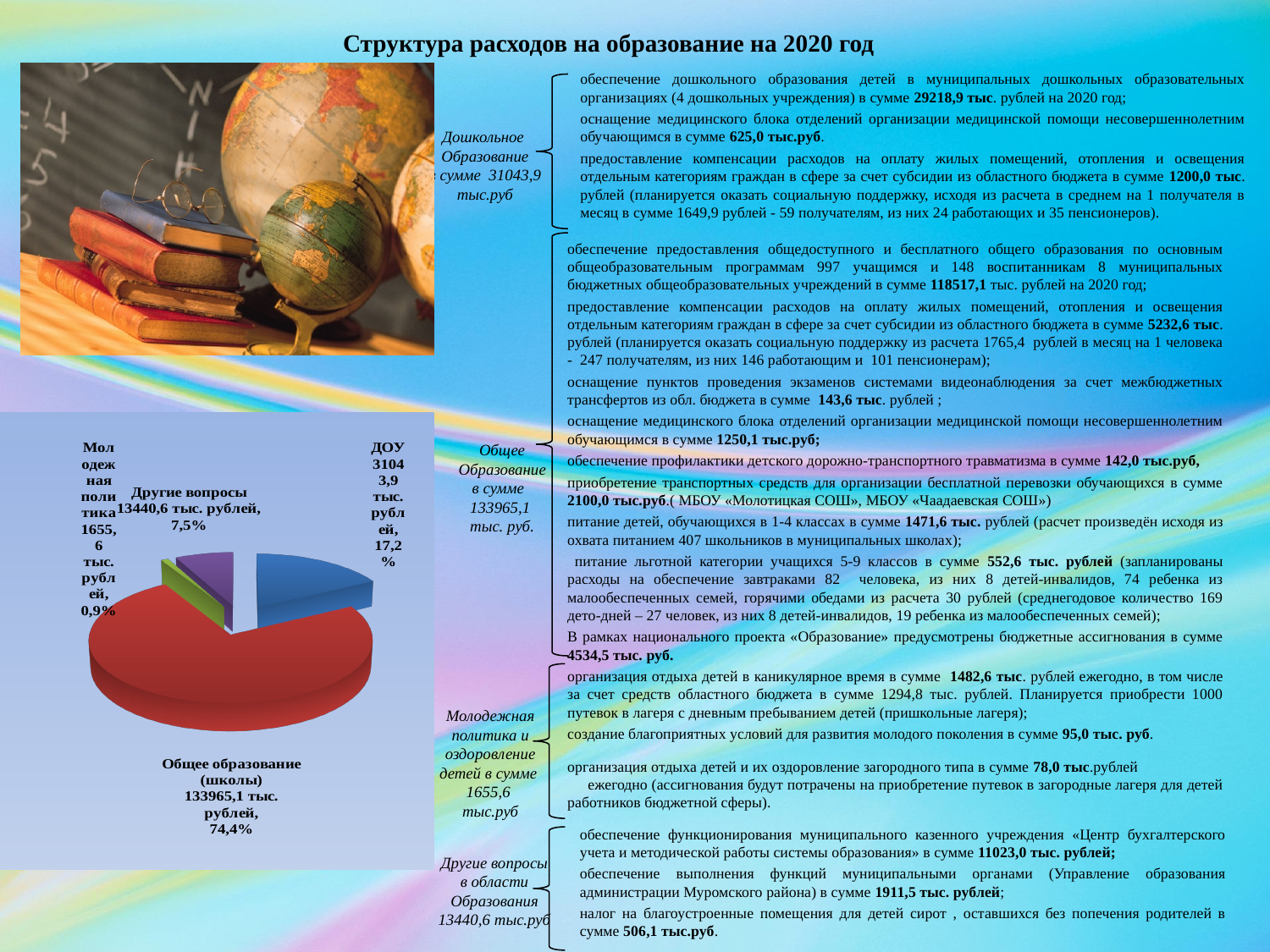
What is the value for ДОУ in the pie chart? 31043,9 тыс. рублей What share of the pie does ДОУ take? 17,2% Which is larger, the value for ДОУ or the value for Другие вопросы? ДОУ What is the value for Другие вопросы in the pie chart? 13440,6 тыс. рублей What is the value for Молодежная политика in the pie chart? 1655,6 тыс. рублей How many slices does the pie chart have? 4 What is the value for Общее образование (школы) in the pie chart? 133965,1 тыс. рублей What kind of chart is shown on the slide? Pie chart Which slice of the pie chart is the smallest? Молодежная политика What is the difference between the values for Общее образование (школы) and ДОУ? 102921,2 тыс. рублей What share of the pie does Общее образование (школы) take? 74,4% Which slice of the pie chart is the largest? Общее образование (школы)